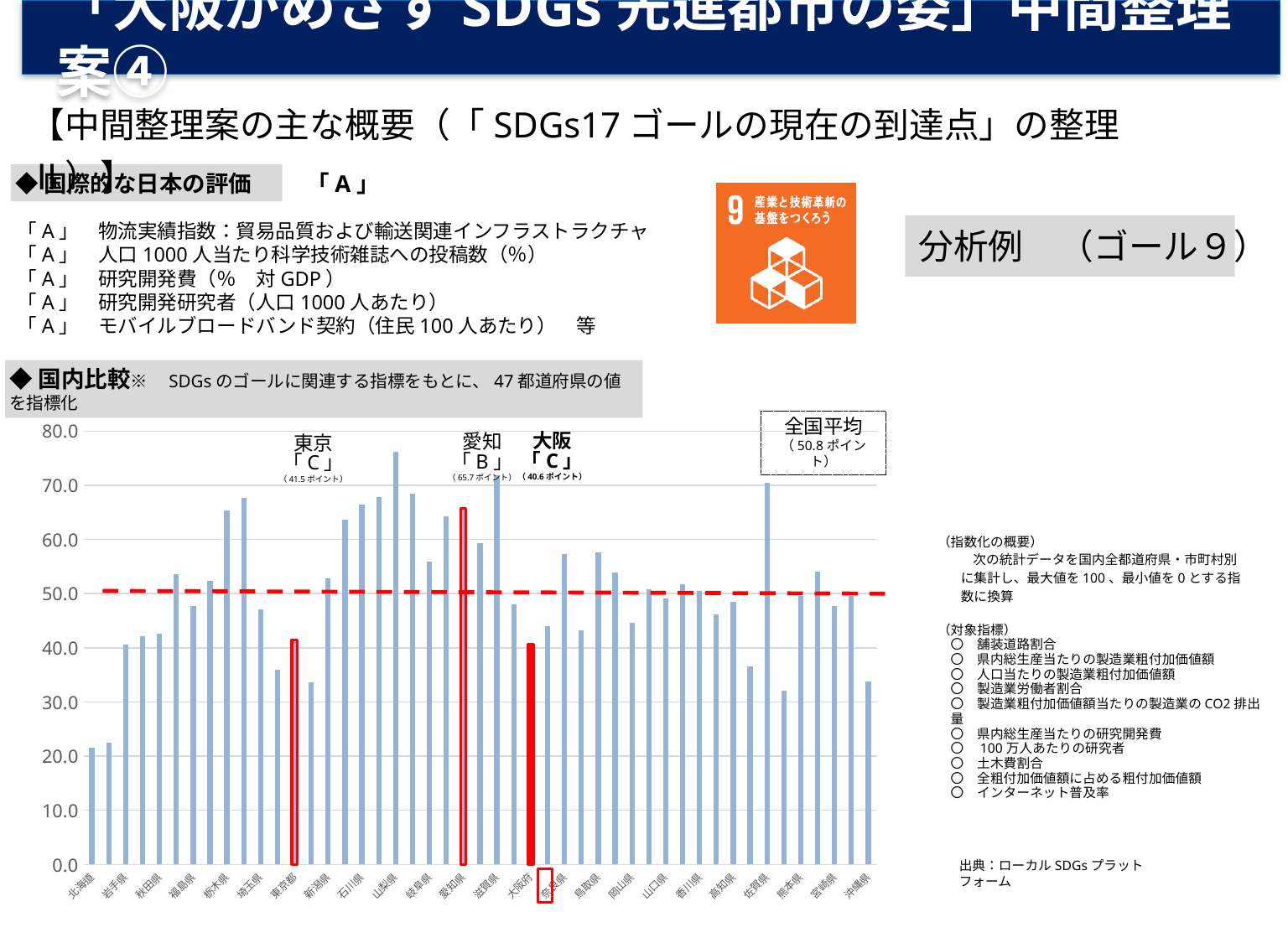
What kind of chart is used for the 国内比較? bar chart What is the 全国平均 value shown on the chart? 50.8 ポイント What is the difference between the values for 東京 and 大阪? 0.9 ポイント Is the value for 沖縄県 greater or less than 40? less What is the difference between the values for 愛知 and 大阪? 25.1 ポイント Is the value for 北海道 greater or less than 30? less Which has the larger value, 愛知 or 東京? 愛知 What is the value shown for 大阪 in the 国内比較 chart? 40.6 ポイント How many prefectures (bars) are plotted in the chart? 47 What is the value shown for 愛知 in the 国内比較 chart? 65.7 ポイント What is the value shown for 東京 in the 国内比較 chart? 41.5 ポイント What grade is shown for 愛知 above the chart? B